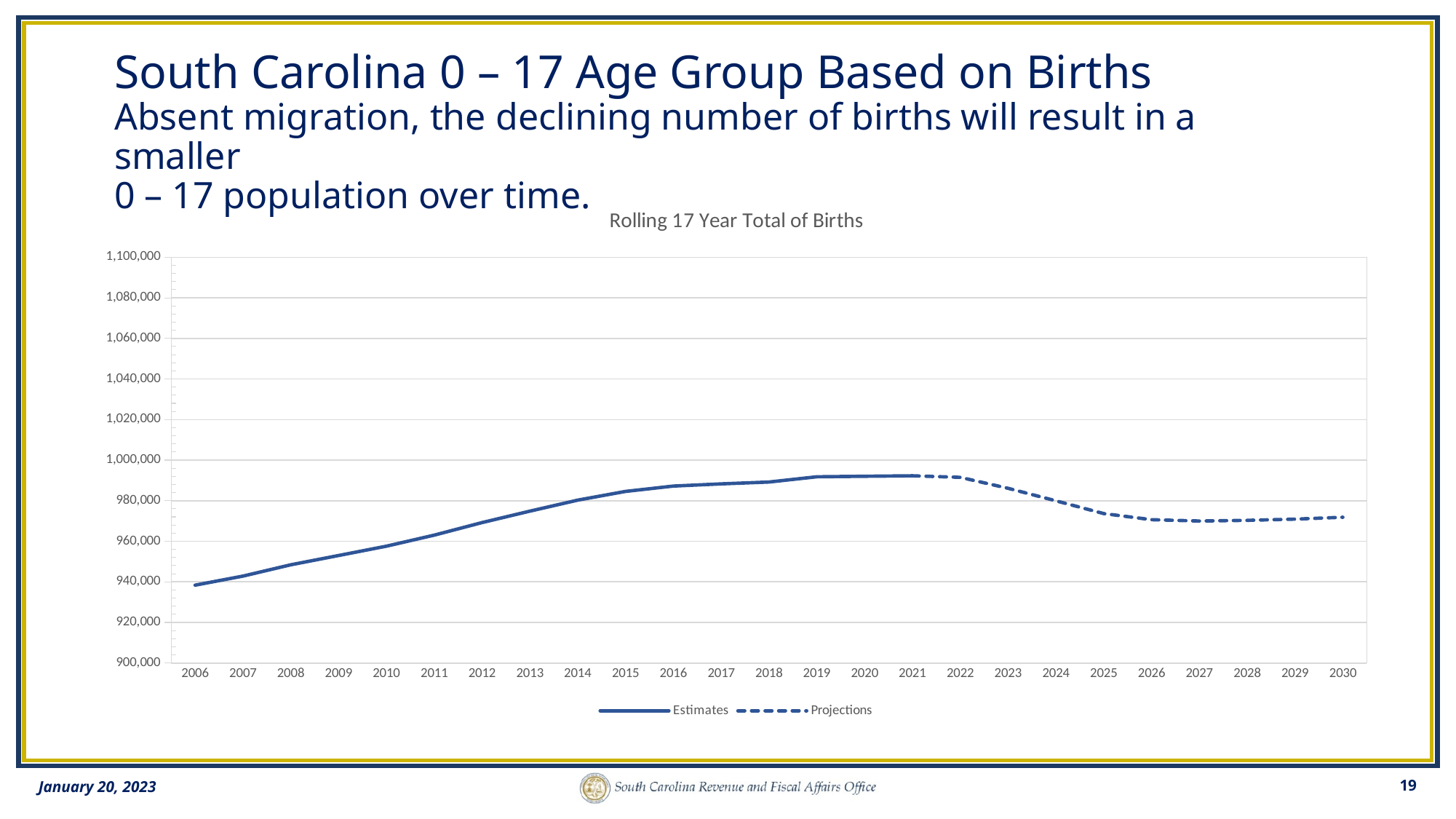
Is the value for 2021 greater or less than 980,000? greater Is the value for 2006 greater or less than 960,000? less Which is larger, the value for 2021 or the projected value for 2030? 2021 Which year has the lowest rolling 17 year total of births? 2006 Does the Estimates series rise or fall from 2006 to 2021? Rise What is the title of the chart? Rolling 17 Year Total of Births Is the projected value for 2030 greater or less than 980,000? less How many years are labelled along the x axis? 25 What type of chart is shown on the slide? Line chart Which series is drawn with a dashed line? Projections How many series does the chart legend list? 2